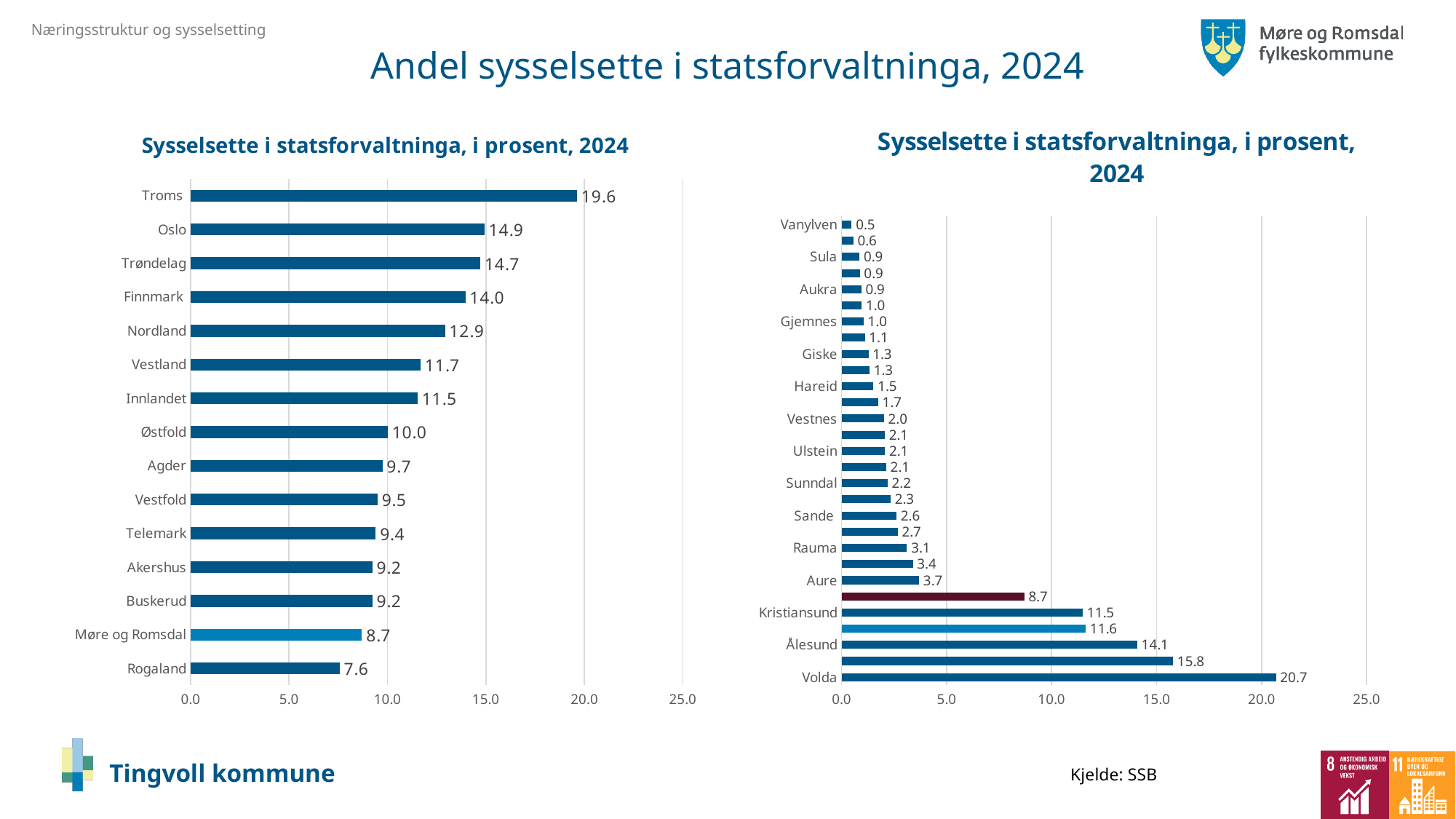
On the right chart, what is the value for Kristiansund? 11.5 On the left chart, what is the value for Troms? 19.6 On the left chart, what is the difference between the values for Oslo and Trøndelag? 0.2 On the right chart, which category has the highest value? Volda What kind of chart is the left chart? Bar chart On the right chart, which bar is shown in a dark red colour rather than blue? The bar with value 8.7 On the right chart, what is the difference between the values for Ålesund and Aure? 10.4 On the left chart, what is the value for Møre og Romsdal? 8.7 On the right chart, what is the value for Volda? 20.7 How many categories are shown on the left chart? 15 On the left chart, which category has the lowest value? Rogaland On the left chart, which is larger, the value for Nordland or the value for Vestland? Nordland